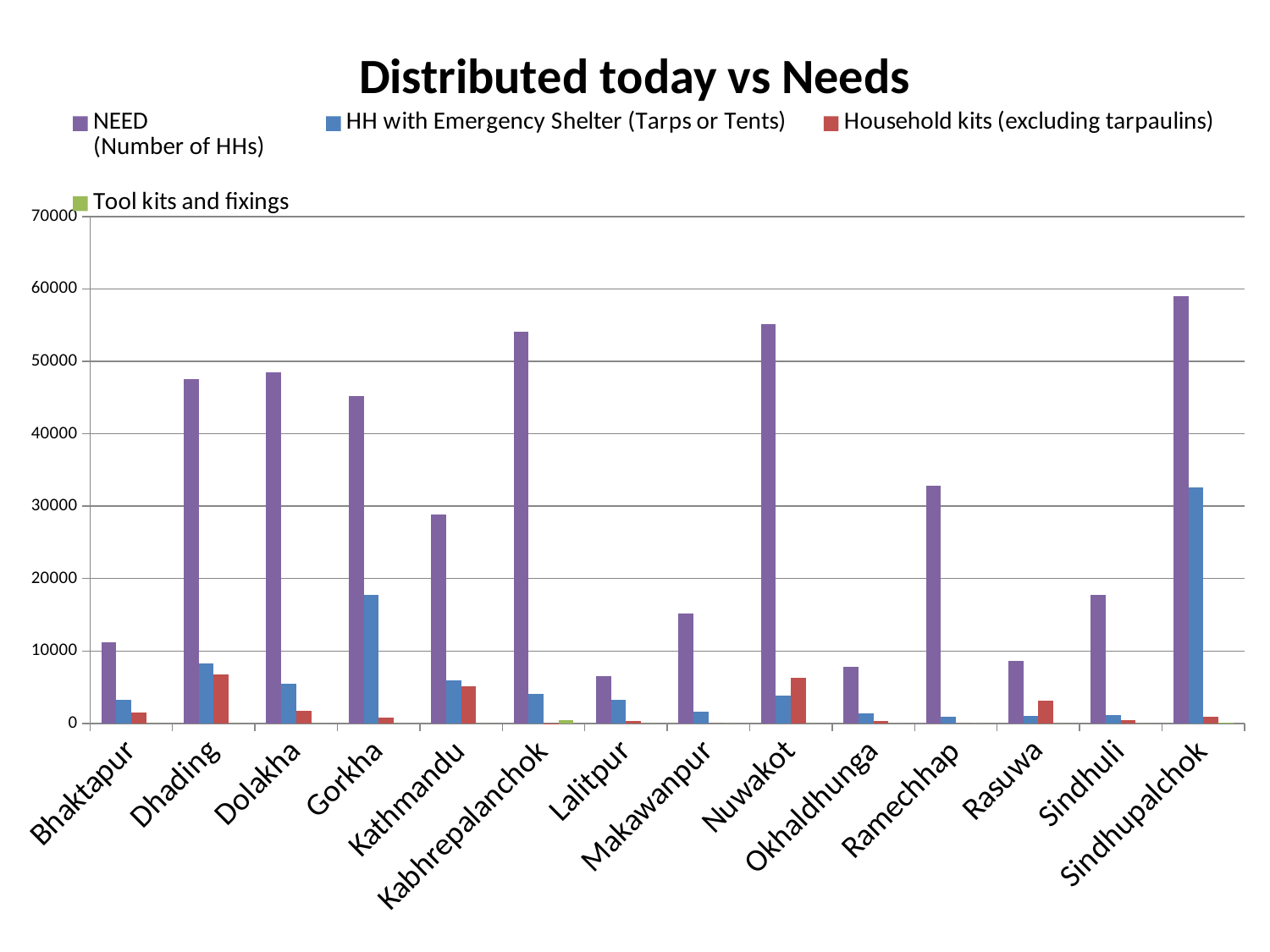
Which district has the highest value for HH with Emergency Shelter (Tarps or Tents)? Sindhupalchok Is the NEED (Number of HHs) value for Kabhrepalanchok greater or less than 50000? greater Is the HH with Emergency Shelter (Tarps or Tents) value for Sindhupalchok greater or less than 30000? greater Is the HH with Emergency Shelter (Tarps or Tents) value for Gorkha greater or less than 10000? greater Which district has the highest NEED (Number of HHs)? Sindhupalchok What type of chart is shown on the slide? Bar chart What is the title of the chart? Distributed today vs Needs How many series does the legend list? 4 How many districts (categories) are shown on the x axis? 14 Which is larger, the NEED (Number of HHs) for Gorkha or for Kathmandu? Gorkha Which is larger, the Household kits (excluding tarpaulins) value for Dhading or for Rasuwa? Dhading